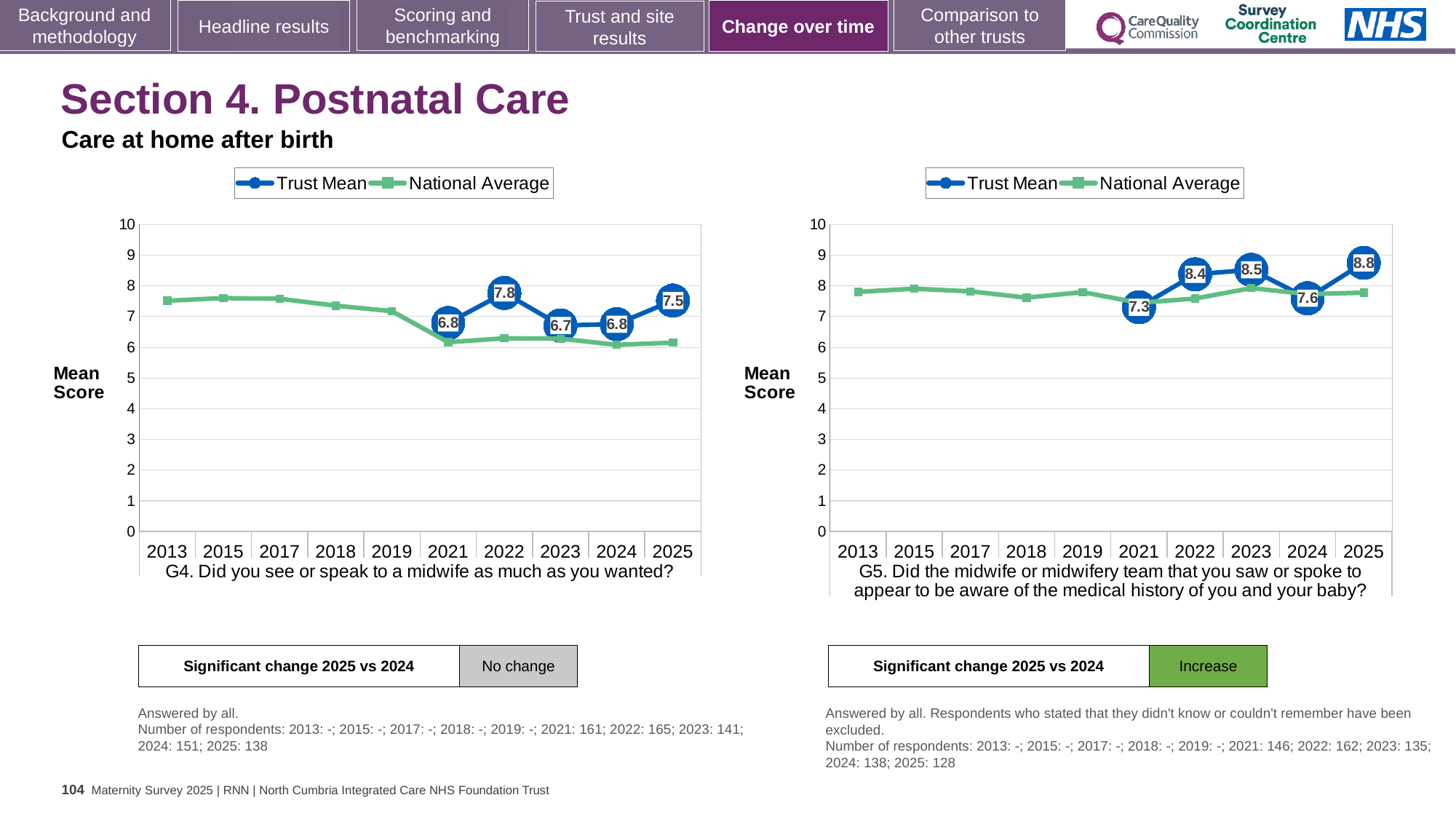
In the G4 chart on the left, what is the Trust Mean for 2025? 7.5 In the G5 chart on the right, what is the Trust Mean for 2021? 7.3 In the G4 chart on the left, what is the difference between the Trust Mean for 2022 and the Trust Mean for 2023? 1.1 In the G4 chart on the left, which year has the lowest labelled Trust Mean? 2023 In the G5 chart on the right, what is the difference between the Trust Mean for 2025 and the Trust Mean for 2024? 1.2 In the G4 chart on the left, is the National Average for 2025 greater or less than 7? less How many series does the legend of the G5 chart on the right list? 2 In the G5 chart on the right, which is larger: the Trust Mean for 2022 or the Trust Mean for 2023? 2023 In the G4 chart on the left, what is the Trust Mean for 2022? 7.8 In the G5 chart on the right, what is the Trust Mean for 2025? 8.8 In the G5 chart on the right, which year has the highest labelled Trust Mean? 2025 What kind of chart is the G4 chart on the left? Line chart